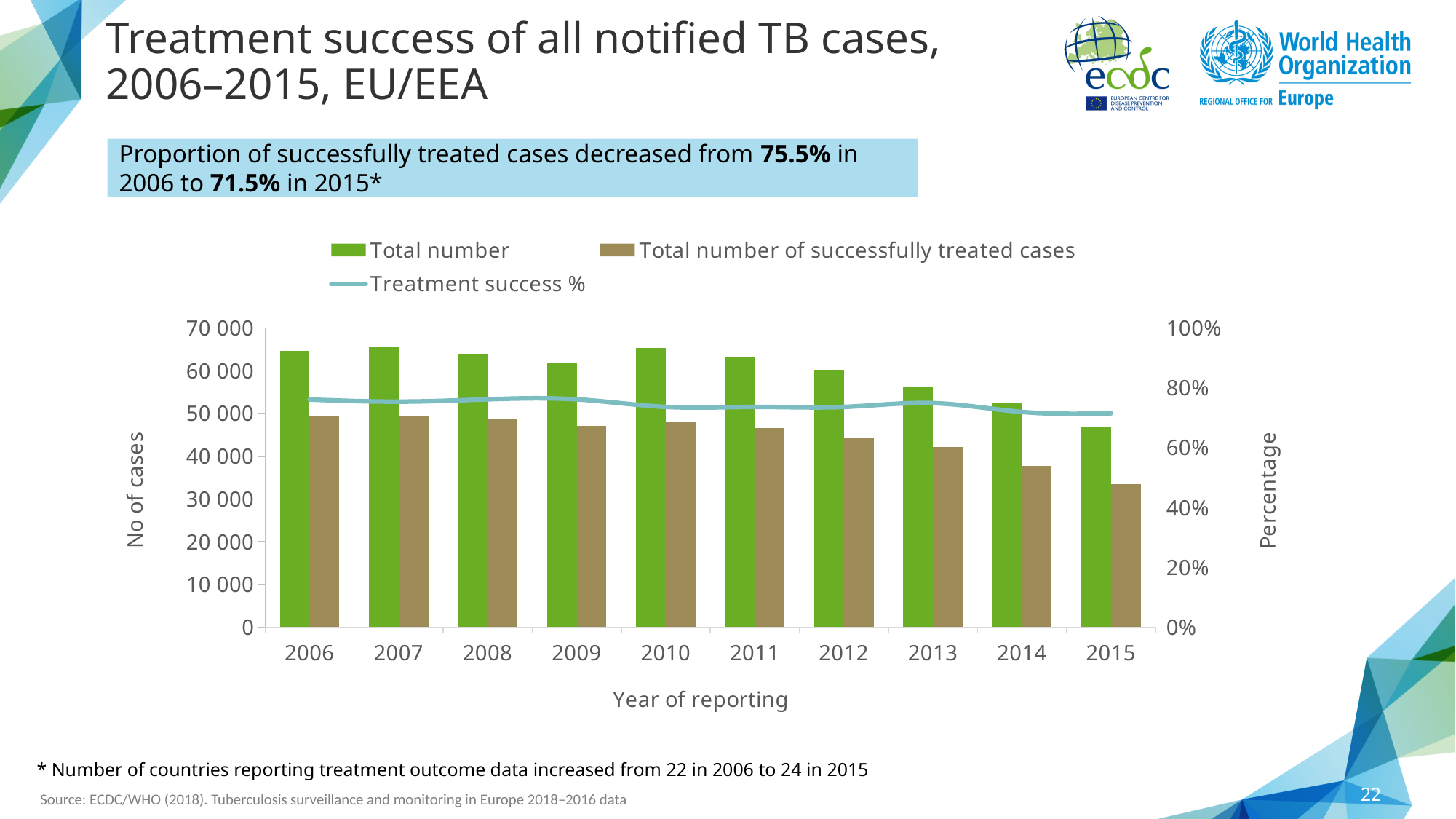
Which year has the lowest Total number of cases? 2015 Does the Total number of successfully treated cases generally rise or fall from 2006 to 2015? fall By how many percentage points did treatment success decrease from 2006 to 2015? 4 percentage points How many series does the chart legend list? 3 How many years are shown on the x axis of the chart? 10 What is the title of the x axis of the chart? Year of reporting What kind of chart is shown on the slide? Bar chart with a line Which is larger: the Total number of successfully treated cases in 2013 or in 2014? 2013 What was the treatment success percentage in 2015? 71.5% Is the Total number of successfully treated cases in 2015 greater or less than 40 000? less Is the Total number of cases in 2006 greater or less than 60 000? greater What was the treatment success percentage in 2006? 75.5%